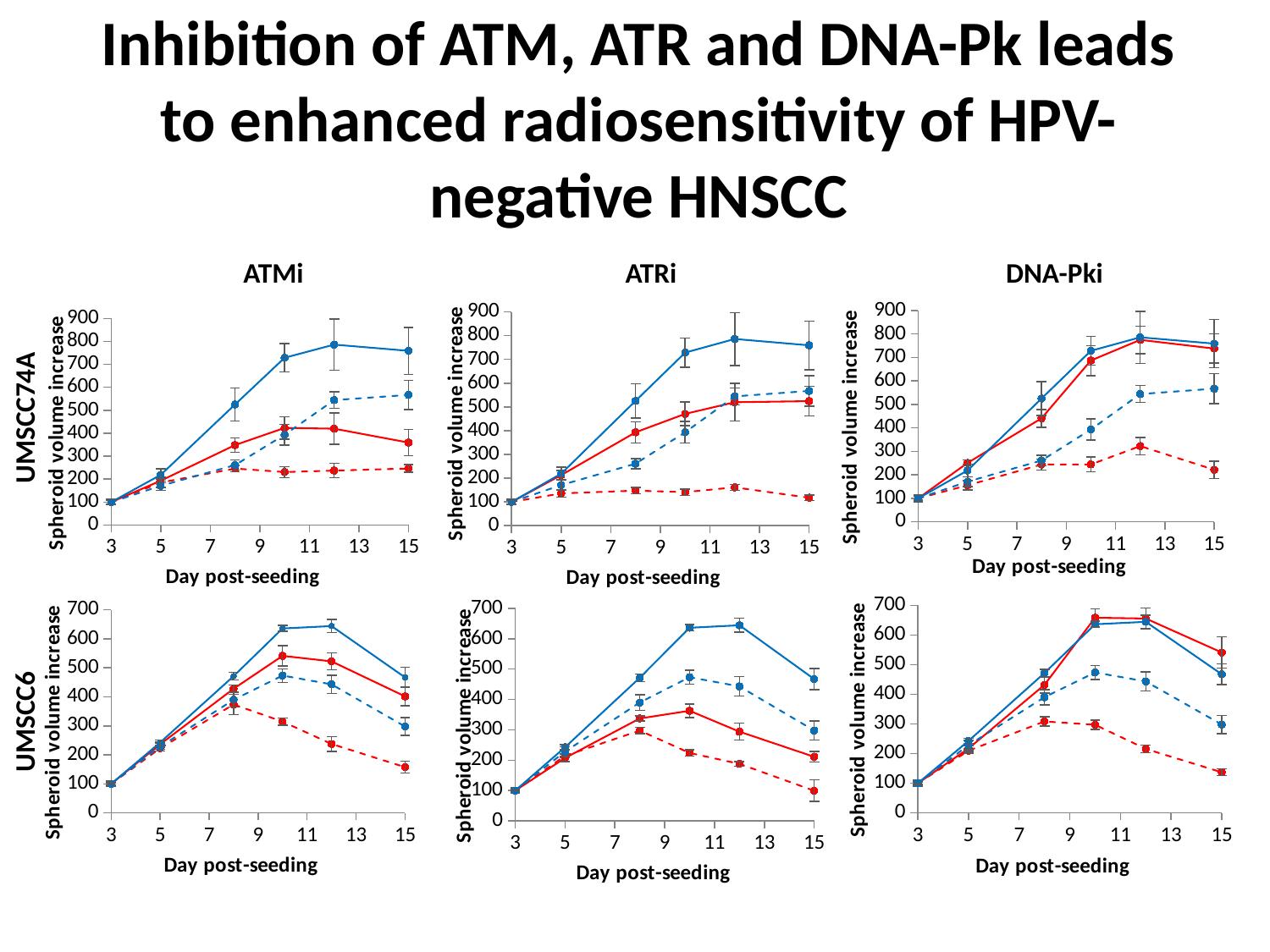
In the UMSCC6 ATRi chart (bottom middle), does the solid red line rise or fall between day 3 and day 10? rise In the UMSCC74A ATMi chart (top left), which is larger at day 15: the solid blue line or the solid red line? solid blue line What is the x-axis title of the charts? Day post-seeding What is the y-axis title of the charts? Spheroid volume increase In the UMSCC74A ATMi chart (top left), is the value of the solid blue line at day 12 greater or less than 700? greater In the UMSCC74A ATMi chart (top left), is the value of the dashed red line at day 15 greater or less than 300? less What kind of chart is used in each of the six panels on the slide? Line chart In the UMSCC6 ATMi chart (bottom left), does the solid blue line rise or fall between day 12 and day 15? fall How many charts are shown on the slide? 6 In the UMSCC74A ATRi chart (top middle), is the value of the dashed red line at day 12 greater or less than 200? less